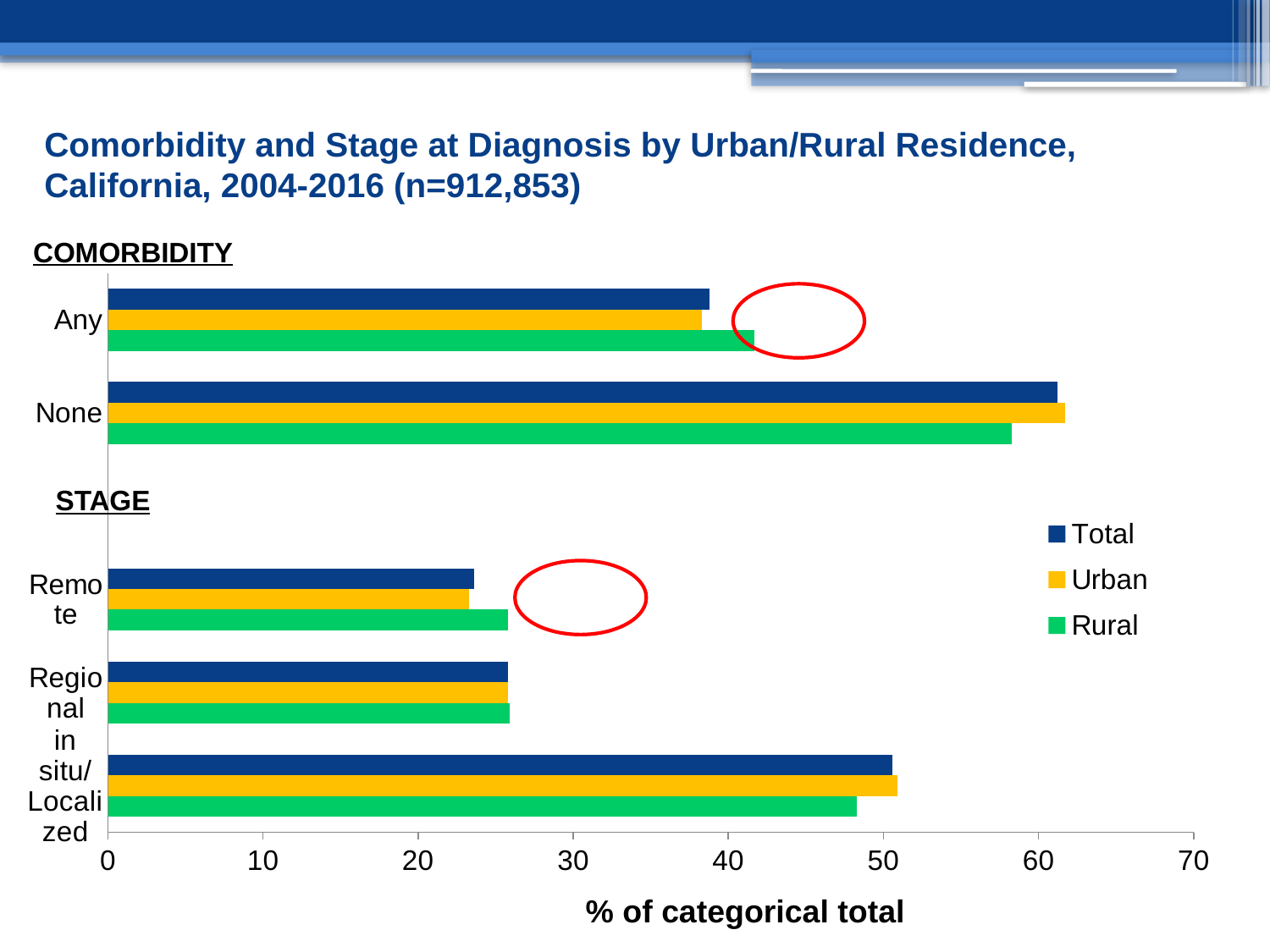
Which colour represents the Total series in the legend? dark blue What is the title of the x axis? % of categorical total Is the Rural value for None (comorbidity) greater or less than 60? less Is the Rural value for Any comorbidity greater or less than 40? greater Which category has the highest Total value? None What kind of chart is shown on the slide? bar chart Is the Rural value for In situ/Localized stage greater or less than 50? less For Any comorbidity, which is larger, the Urban value or the Rural value? Rural How many categories are plotted on the chart? 5 How many series does the legend list? 3